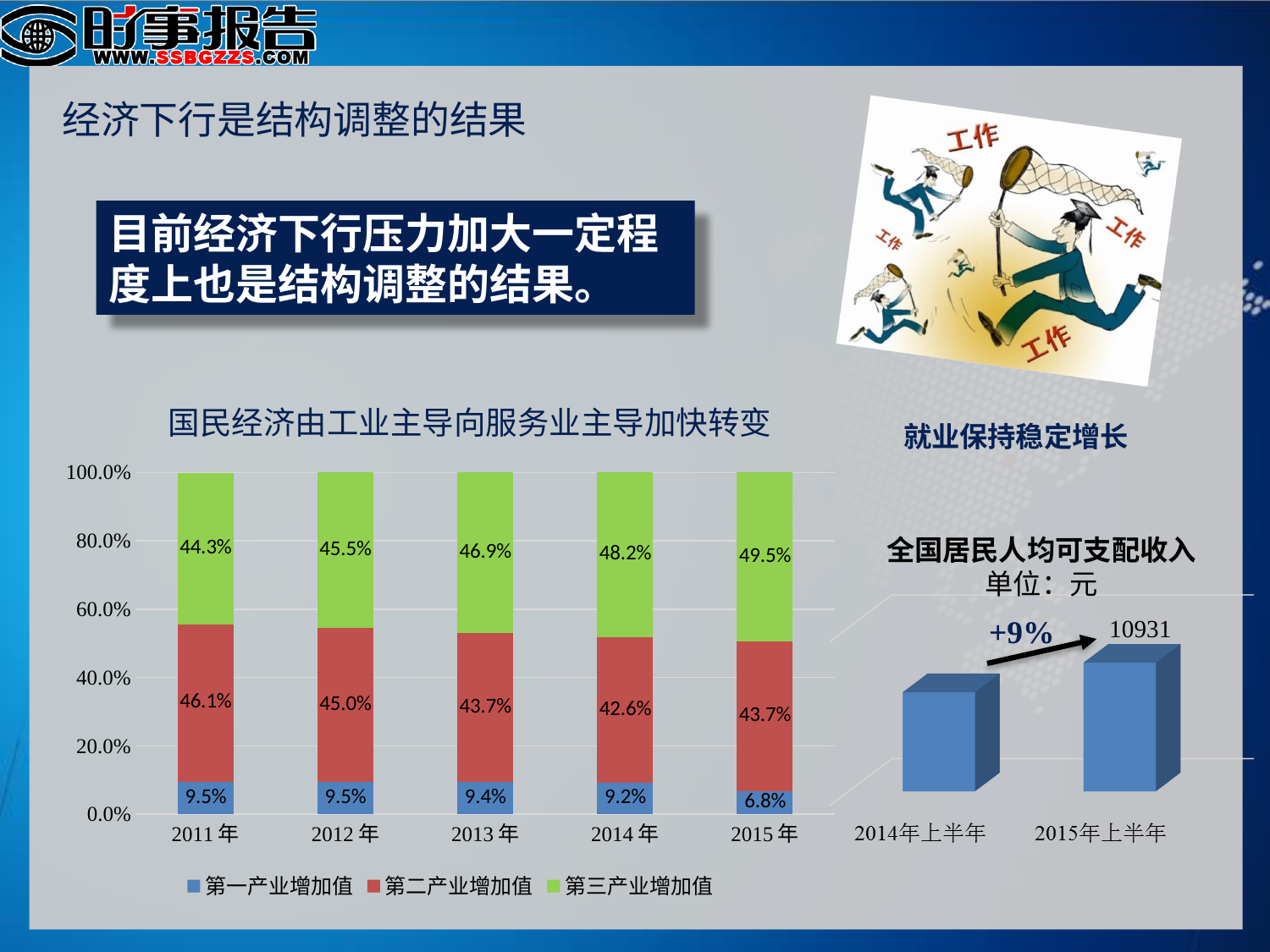
In the chart titled 国民经济由工业主导向服务业主导加快转变, which is larger for 2014 年: 第二产业增加值 or 第三产业增加值? 第三产业增加值 In the chart titled 国民经济由工业主导向服务业主导加快转变, what is the value of 第三产业增加值 for 2015 年? 49.5% In the chart titled 国民经济由工业主导向服务业主导加快转变, what is the value of 第一产业增加值 for 2013 年? 9.4% In the chart titled 国民经济由工业主导向服务业主导加快转变, which year has the highest value for 第三产业增加值? 2015 年 In the chart titled 全国居民人均可支配收入, what is the value for 2015年上半年? 10931 In the chart titled 国民经济由工业主导向服务业主导加快转变, does the value of 第三产业增加值 rise or fall from 2011 年 to 2015 年? rise In the chart titled 国民经济由工业主导向服务业主导加快转变, how many series does the legend list? 3 In the chart titled 国民经济由工业主导向服务业主导加快转变, what is the difference between the 第三产业增加值 values for 2015 年 and 2011 年? 5.2% In the chart titled 国民经济由工业主导向服务业主导加快转变, what is the value of 第二产业增加值 for 2011 年? 46.1% In the chart titled 国民经济由工业主导向服务业主导加快转变, which year has the lowest value for 第一产业增加值? 2015 年 What kind of chart is the chart titled 全国居民人均可支配收入? bar chart In the chart titled 国民经济由工业主导向服务业主导加快转变, how many years are shown on the x axis? 5